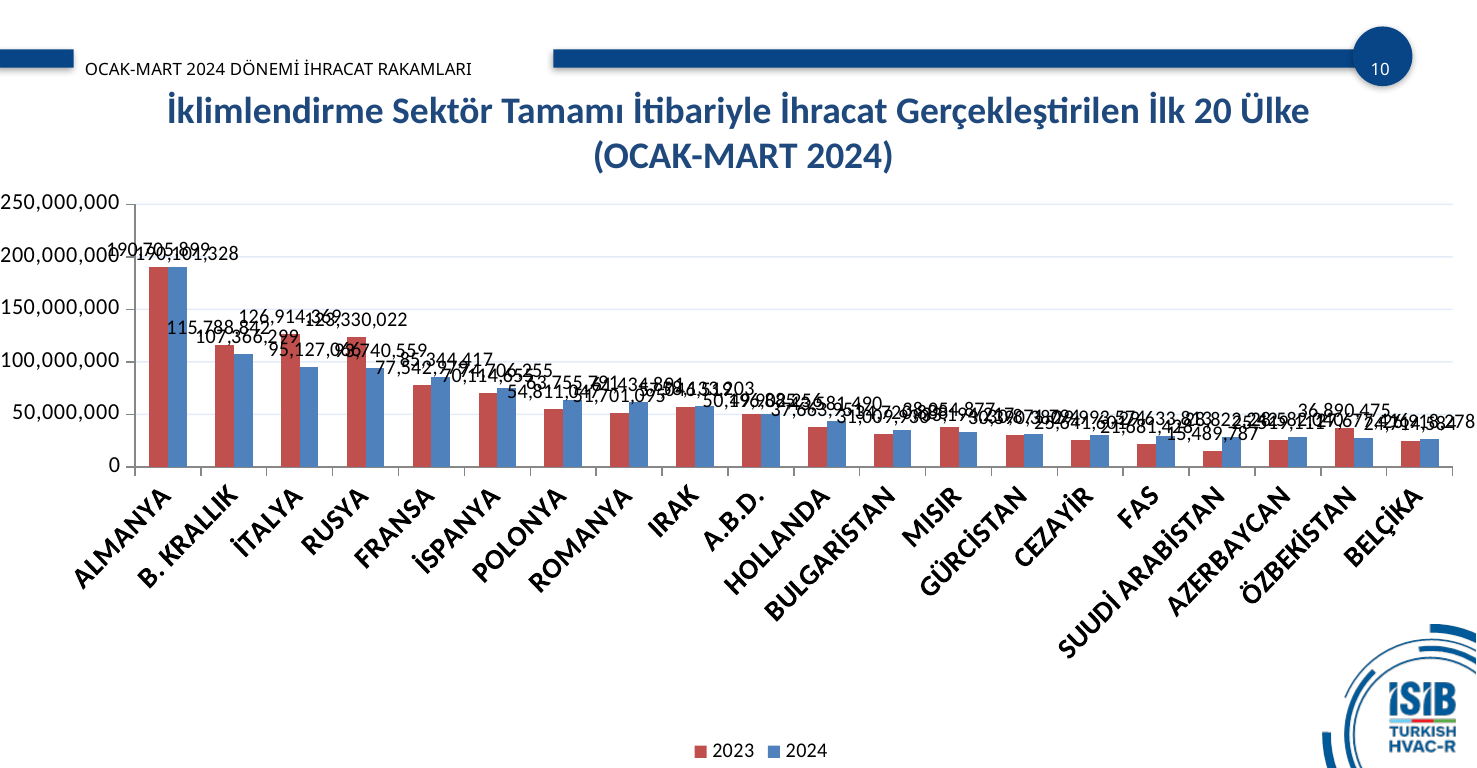
For İTALYA, which year has the larger value, 2023 or 2024? 2023 Which two years are listed in the chart legend? 2023 and 2024 Which country has the highest 2024 value in the chart? ALMANYA How many series does the legend list? 2 How many countries are shown on the x axis of the chart? 20 Is the 2024 value for RUSYA greater or less than 100,000,000? less Is the 2023 value for CEZAYİR greater or less than 50,000,000? less Is the 2023 value for ALMANYA greater or less than 150,000,000? greater What kind of chart is shown on the slide? bar chart Which country has the lowest 2023 value in the chart? SUUDİ ARABİSTAN For SUUDİ ARABİSTAN, which year has the larger value, 2023 or 2024? 2024 For FRANSA, which year has the larger value, 2023 or 2024? 2024